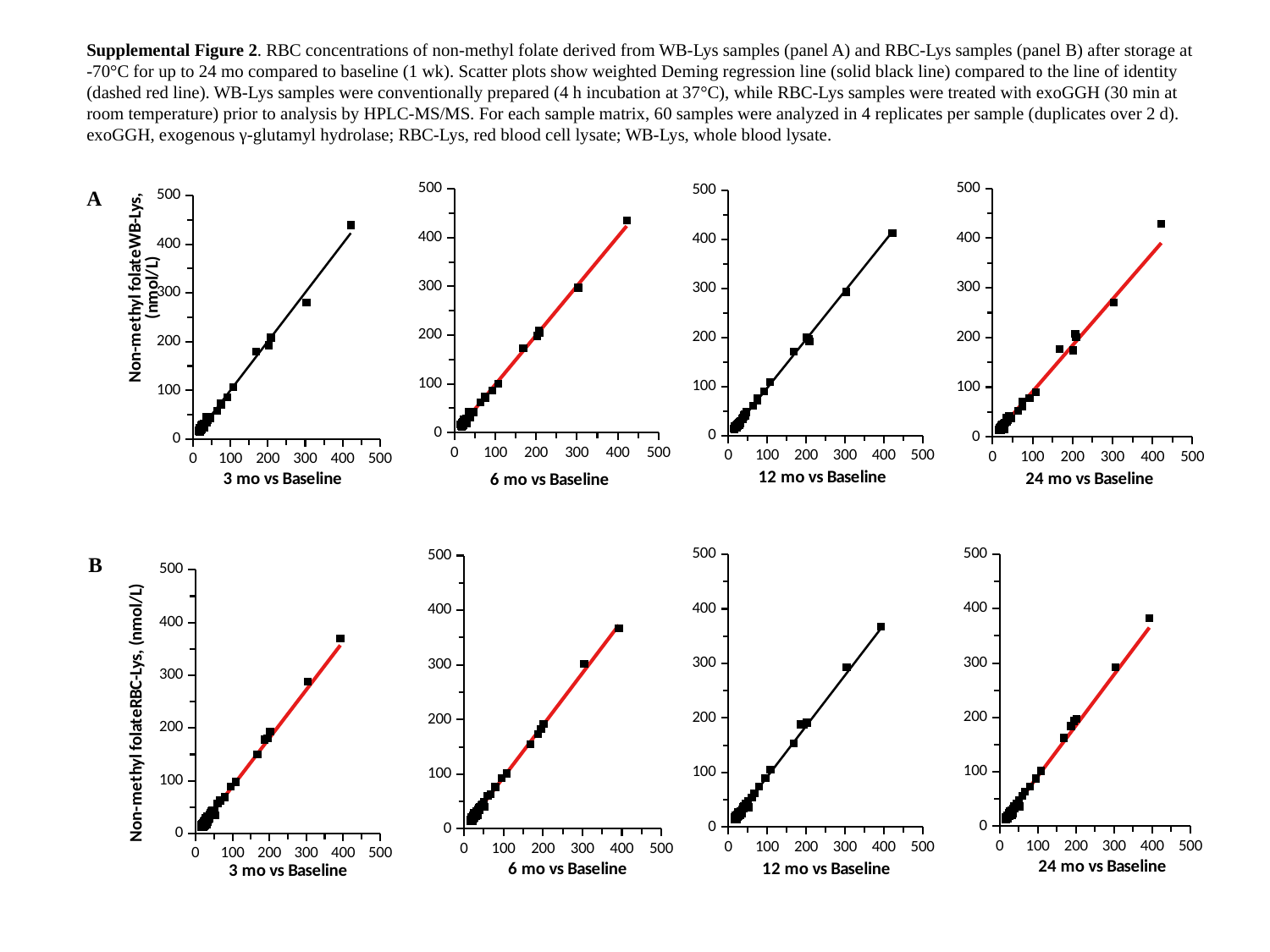
How many charts are in panel A (the top row)? 4 What is the maximum value shown on the y axis of the panel B '6 mo vs Baseline' chart? 500 What is the x-axis label of the third chart in panel A? 12 mo vs Baseline How many charts are shown on the slide in total? 8 In the panel A '3 mo vs Baseline' chart, is the value of the highest point greater or less than 400? greater What is the y-axis label of the charts in panel B? Non-methyl folate RBC-Lys, (nmol/L) What kind of chart is used in each of the panels on this slide? Scatter plot In the panel A '12 mo vs Baseline' chart, do the plotted values rise or fall as the baseline value increases along the x axis? rise In the panel B '24 mo vs Baseline' chart, is the value of the highest point greater or less than 300? greater In the panel A '24 mo vs Baseline' chart, is the value of the highest point greater or less than 400? greater